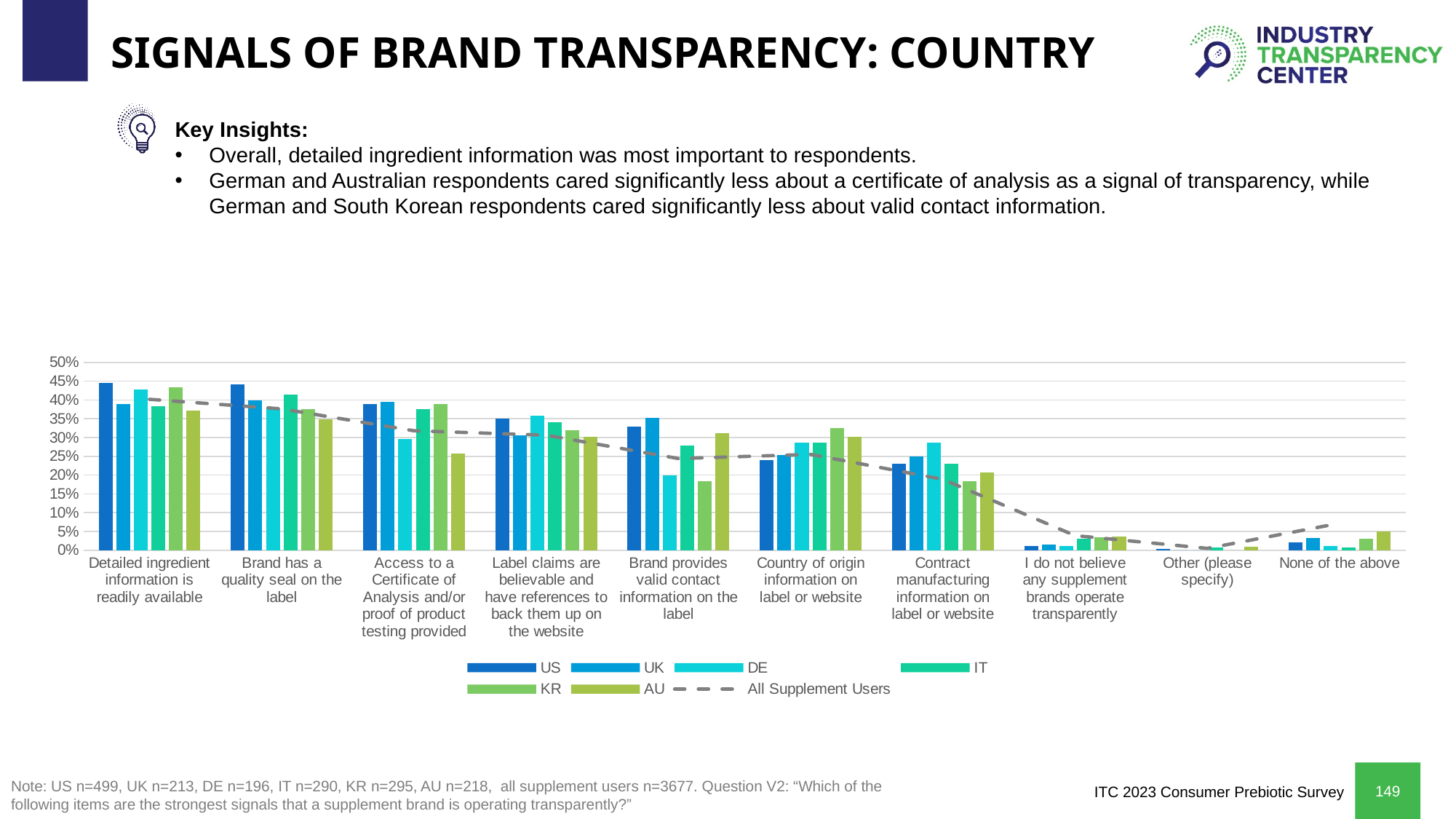
How many entries does the chart's legend list? 7 How many categories are shown along the x axis of the chart? 10 Is the DE value for 'Brand provides valid contact information on the label' greater or less than 25%? less For 'Country of origin information on label or website', which is larger, the KR value or the US value? KR What kind of chart is shown on the slide? combination bar and line chart Which category has the lowest values across all countries? Other (please specify) Is the AU value for 'Access to a Certificate of Analysis and/or proof of product testing provided' greater or less than 30%? less What does the dashed grey line on the chart represent? All Supplement Users For 'Access to a Certificate of Analysis and/or proof of product testing provided', which country has the lowest bar? AU Is the KR value for 'Contract manufacturing information on label or website' greater or less than 25%? less For 'Brand provides valid contact information on the label', which is larger, the UK value or the DE value? UK